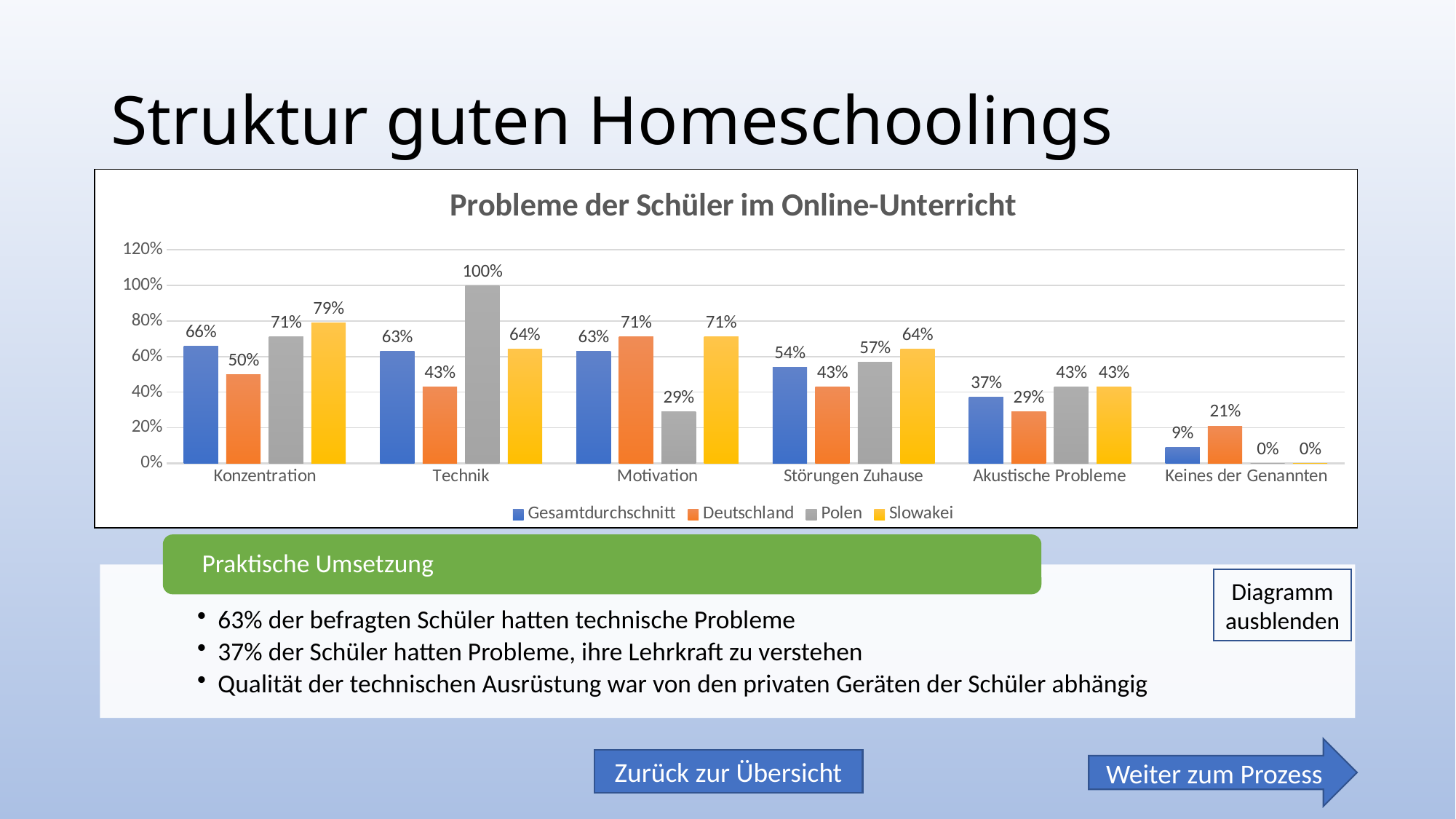
What is the difference between the Polen and Deutschland values in the Technik category? 57% How many categories are shown on the x axis? 6 Which is larger in the Motivation category: the value for Deutschland or the value for Polen? Deutschland What kind of chart is shown on the slide? Bar chart How many series does the legend list? 4 What is the title of the chart? Probleme der Schüler im Online-Unterricht What is the value for Slowakei in the Störungen Zuhause category? 64% What is the value for Polen in the Technik category? 100% What is the value for Deutschland in the Konzentration category? 50% Which category has the lowest value for Gesamtdurchschnitt? Keines der Genannten Which series is shown in yellow? Slowakei Which category has the highest value for Slowakei? Konzentration